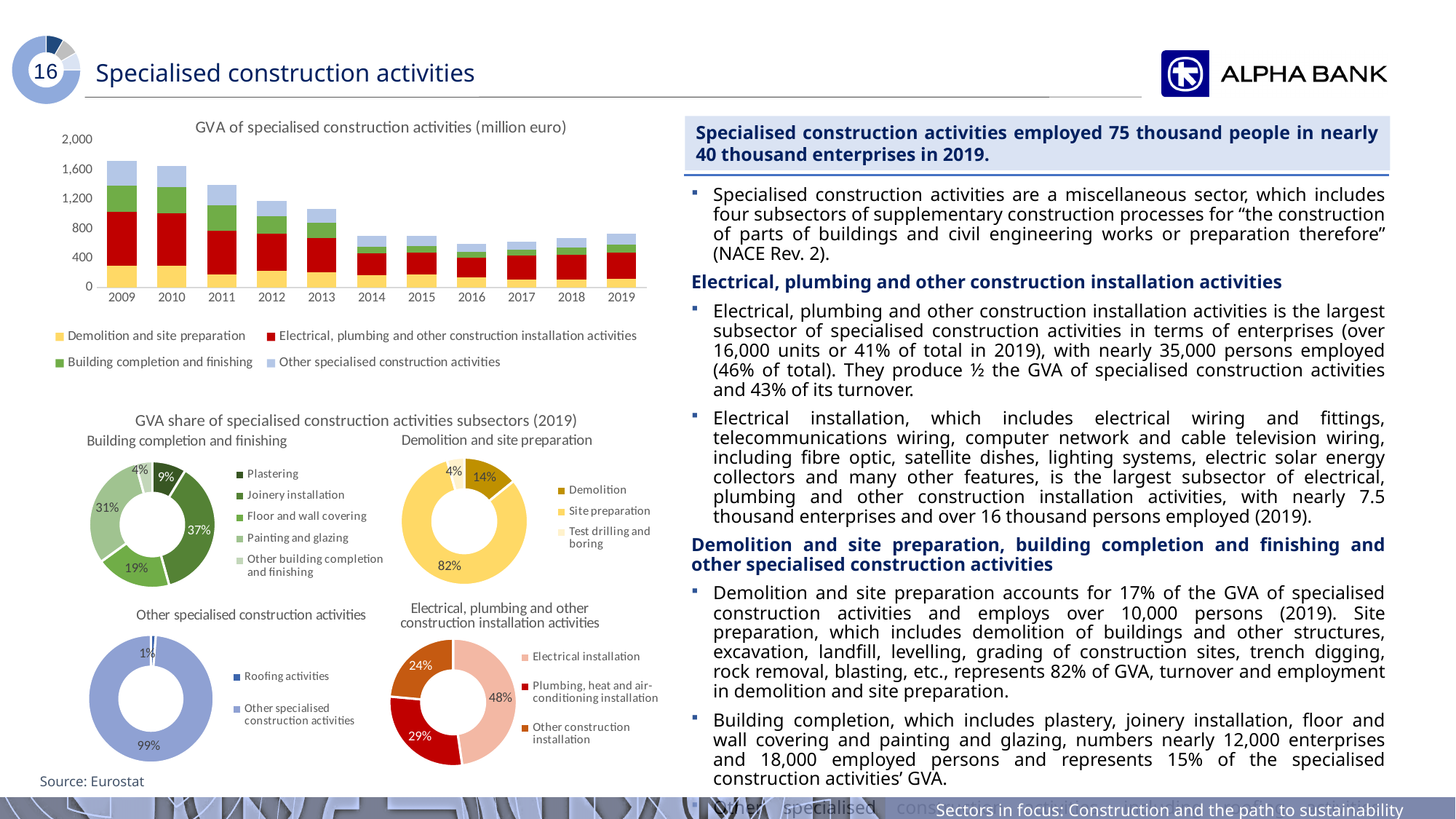
In the chart 'GVA of specialised construction activities (million euro)', does the total GVA generally rise or fall from 2009 to 2019? Fall In the 'Electrical, plumbing and other construction installation activities' donut chart, what share does Electrical installation have? 48% In the chart 'GVA of specialised construction activities (million euro)', how many series does the legend list? 4 In the chart 'GVA of specialised construction activities (million euro)', what kind of chart is used? Stacked bar chart In the 'Demolition and site preparation' donut chart, what share does Site preparation have? 82% In the 'Other specialised construction activities' donut chart, what share do Roofing activities have? 1% In the chart 'GVA of specialised construction activities (million euro)', which year has the highest total GVA? 2009 In the 'Electrical, plumbing and other construction installation activities' donut chart, what is the difference in percentage points between Electrical installation and Plumbing, heat and air-conditioning installation? 19 percentage points In the chart 'GVA of specialised construction activities (million euro)', how many years are shown on the x axis? 11 In the 'Building completion and finishing' donut chart, which subsector has the largest share? Joinery installation In the chart 'GVA of specialised construction activities (million euro)', is the total for 2019 greater or less than 800? less In the chart 'GVA of specialised construction activities (million euro)', is the total for 2009 greater or less than 1,600? greater